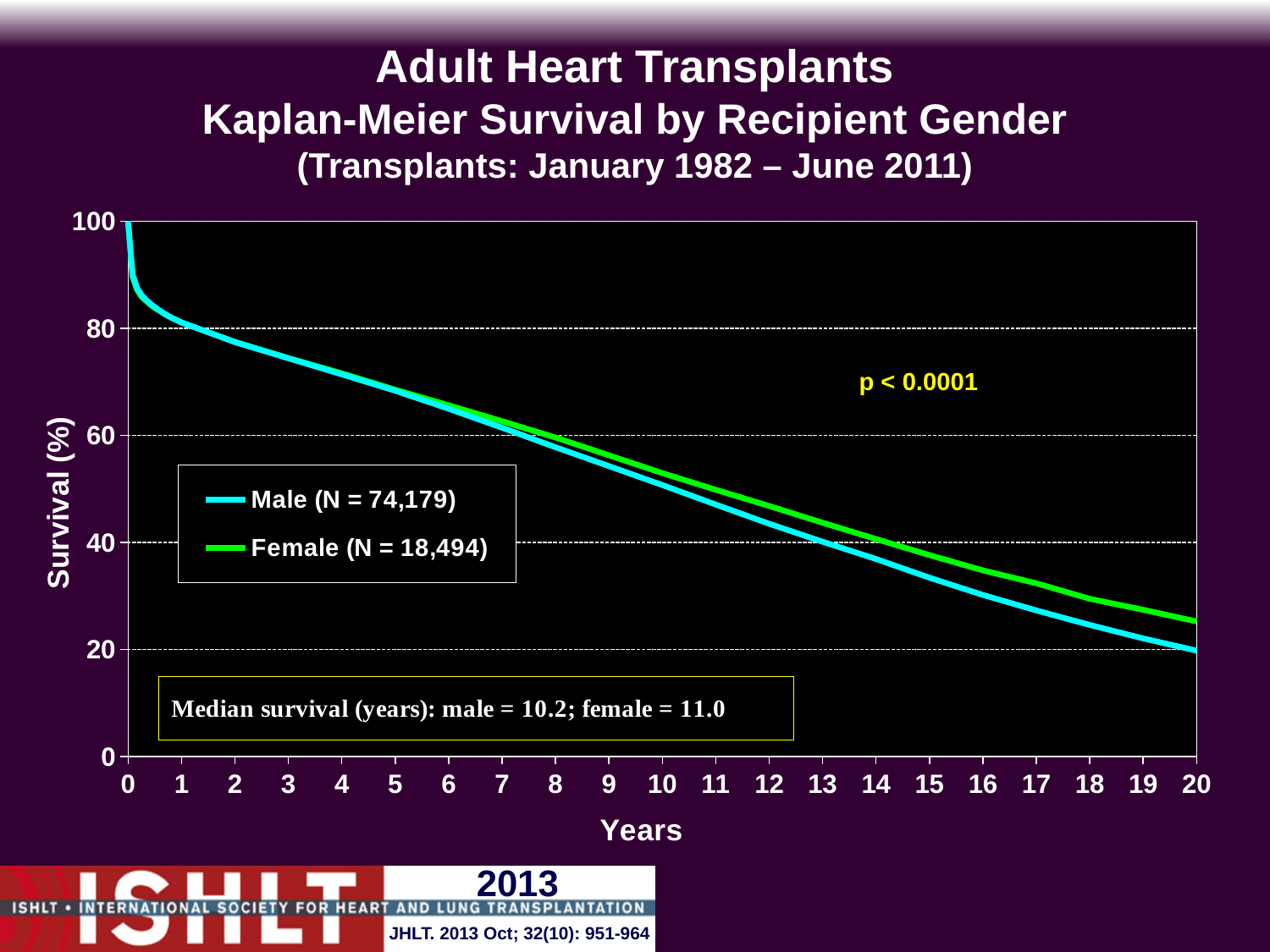
Which group has the longer median survival, male or female? female Do the survival curves rise or fall as years increase? fall What kind of chart is shown on the slide? line chart Is the survival value for the Male curve at 15 years greater or less than 40? less What is the median survival in years for female recipients? 11.0 Is the survival value for the Female curve at 5 years greater or less than 60? greater What is the N for the Male group shown in the legend? 74,179 What is the median survival in years for male recipients? 10.2 What p-value is shown on the chart? p < 0.0001 What is the difference in median survival (years) between female and male recipients? 0.8 How many series does the legend list? 2 What is the N for the Female group shown in the legend? 18,494